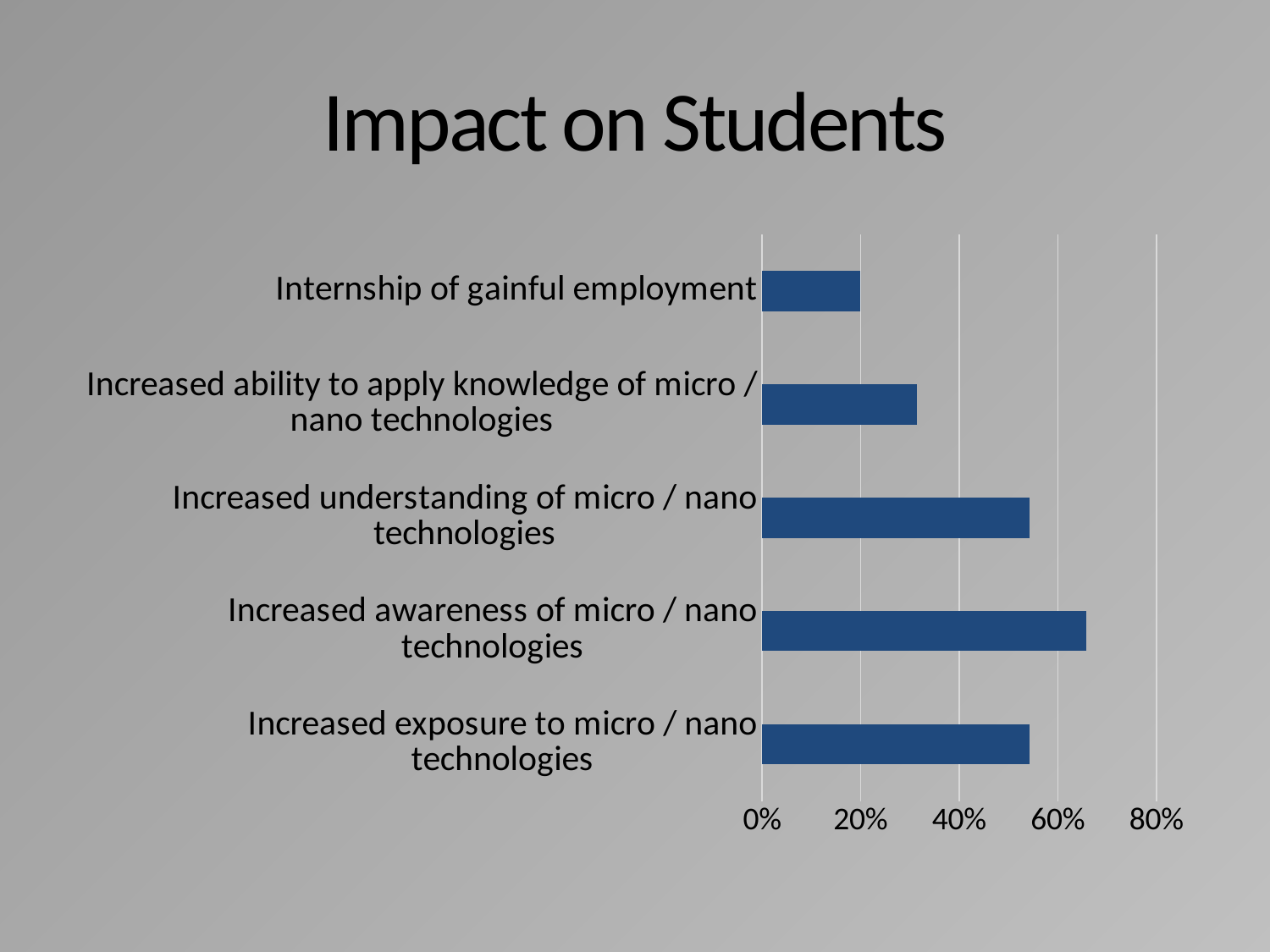
Is the value for Increased exposure to micro / nano technologies greater or less than 40%? greater What is the title of the slide containing the chart? Impact on Students Which is larger: the value for Internship of gainful employment or the value for Increased ability to apply knowledge of micro / nano technologies? Increased ability to apply knowledge of micro / nano technologies Is the value for Increased ability to apply knowledge of micro / nano technologies greater or less than 40%? less Is the value for Internship of gainful employment greater or less than 40%? less Which is larger: the value for Increased awareness of micro / nano technologies or the value for Increased understanding of micro / nano technologies? Increased awareness of micro / nano technologies Which category has the highest value? Increased awareness of micro / nano technologies Which category has the lowest value? Internship of gainful employment How many categories are plotted in the chart? 5 What kind of chart is shown on the slide? bar chart